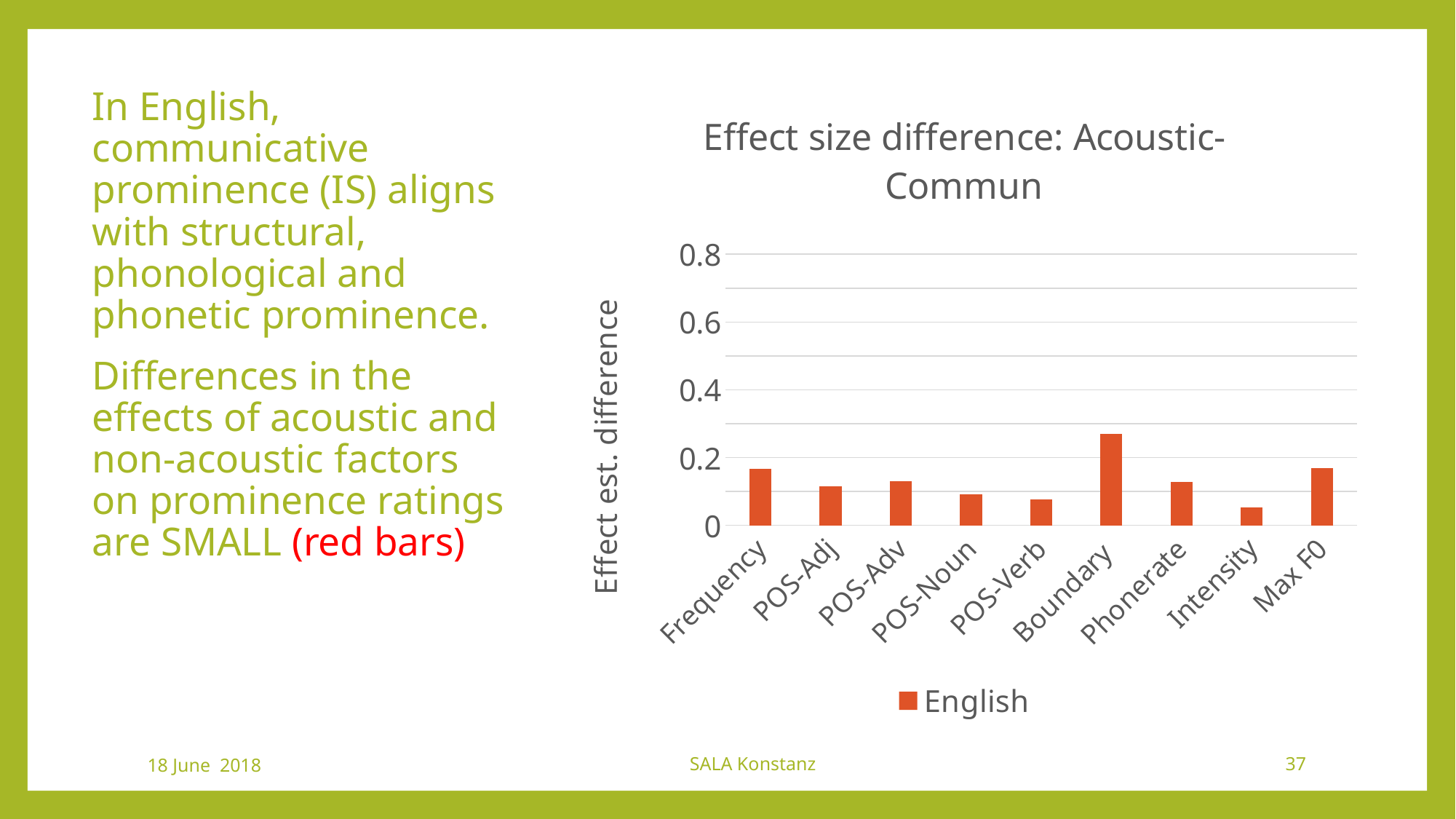
Which category has the highest effect estimate difference? Boundary What kind of chart is shown on the slide? bar chart How many categories are shown on the x axis of the chart? 9 Is the value for Max F0 greater or less than 0.4? less Which category has the lowest effect estimate difference? Intensity Is the value for Intensity greater or less than 0.2? less Is the value for Boundary greater or less than 0.2? greater Which is larger, the value for Boundary or the value for POS-Noun? Boundary What is the title of the chart? Effect size difference: Acoustic-Commun Which is larger, the value for Intensity or the value for Frequency? Frequency How many series does the legend list? 1 What is the label of the vertical axis? Effect est. difference